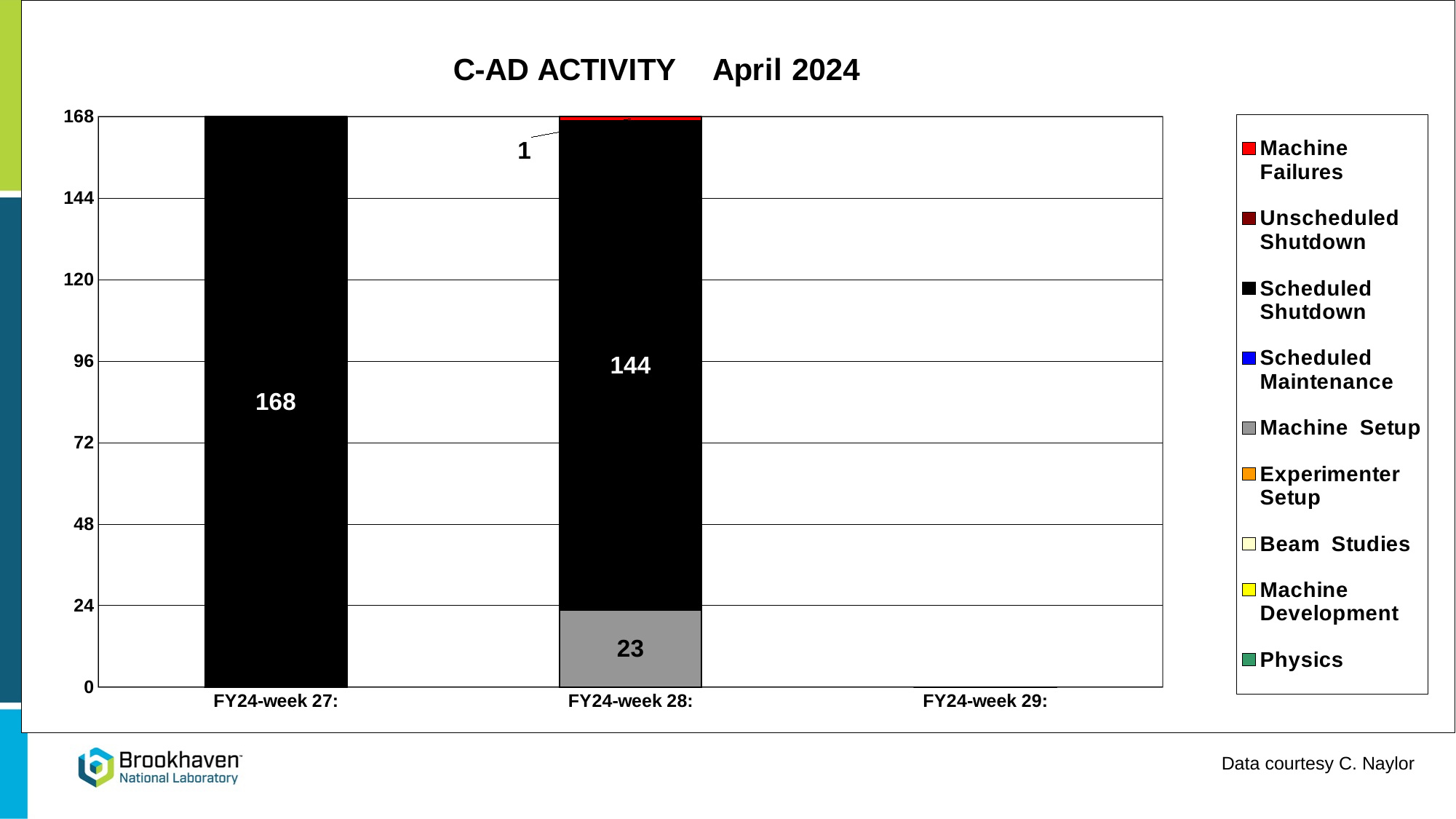
Which category has the larger Scheduled Shutdown value, FY24-week 27 or FY24-week 28? FY24-week 27 How many categories are shown on the x axis? 3 Which colour represents Machine Setup in the legend? Grey What is the Scheduled Shutdown value for FY24-week 27? 168 What is the difference between the Scheduled Shutdown values for FY24-week 27 and FY24-week 28? 24 What is the total of the stacked bar for FY24-week 28? 168 How many series does the legend list? 9 What is the Machine Setup value for FY24-week 28? 23 What is the Scheduled Shutdown value for FY24-week 28? 144 What kind of chart is shown on the slide? Stacked bar chart What is the Machine Failures value for FY24-week 28? 1 What is the title of the chart? C-AD ACTIVITY April 2024